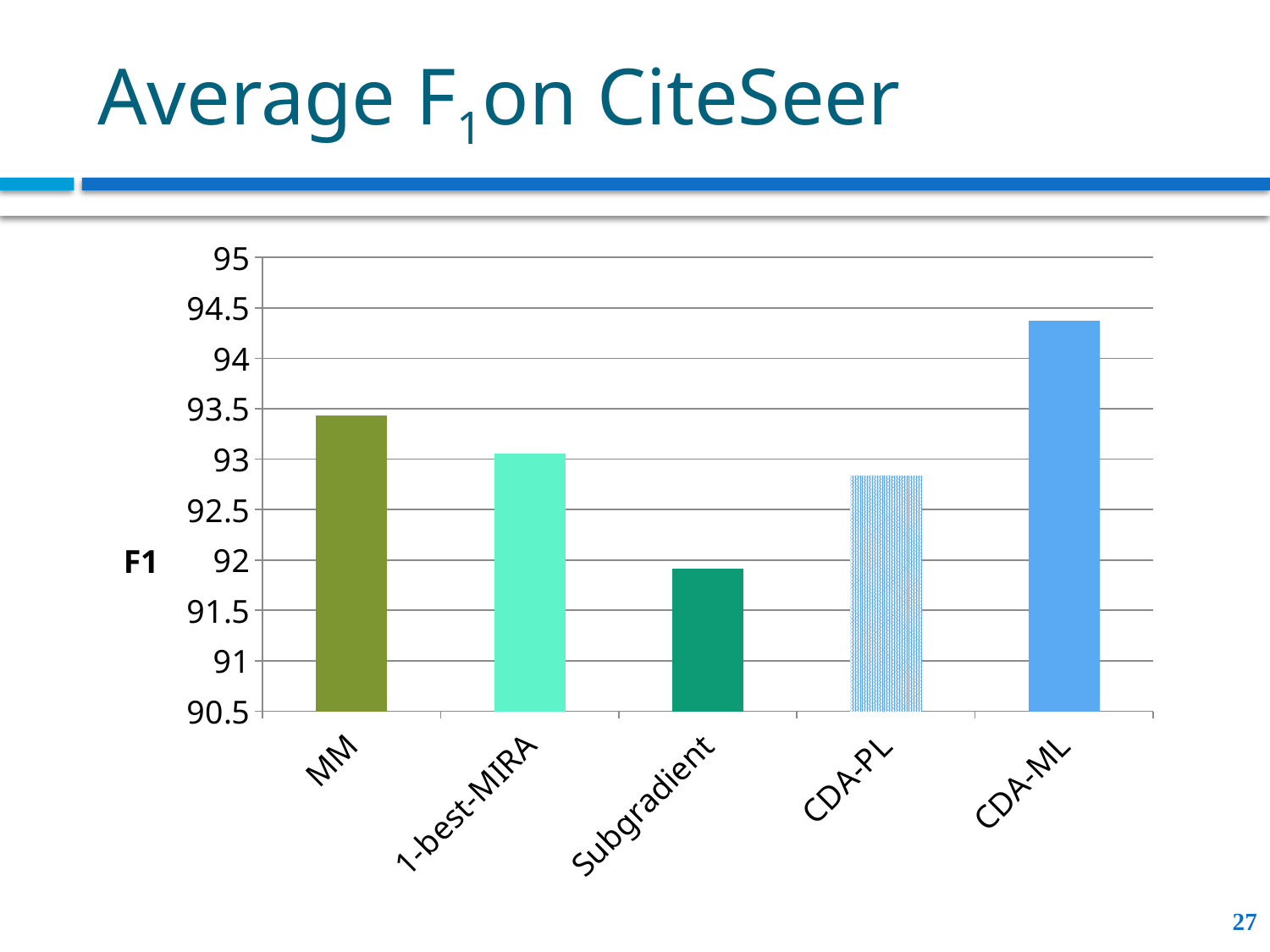
Is the value for Subgradient greater or less than 92.5? less Is the value for 1-best-MIRA greater or less than 92.5? greater Is the value for CDA-ML greater or less than 94? greater What type of chart is shown on the slide? bar chart How many categories (methods) are plotted in the chart? 5 What is the label on the vertical axis of the chart? F1 Which has a higher F1: CDA-ML or MM? CDA-ML Which method has the lowest average F1 on CiteSeer? Subgradient Which has a higher F1: MM or 1-best-MIRA? MM Which method has the highest average F1 on CiteSeer? CDA-ML